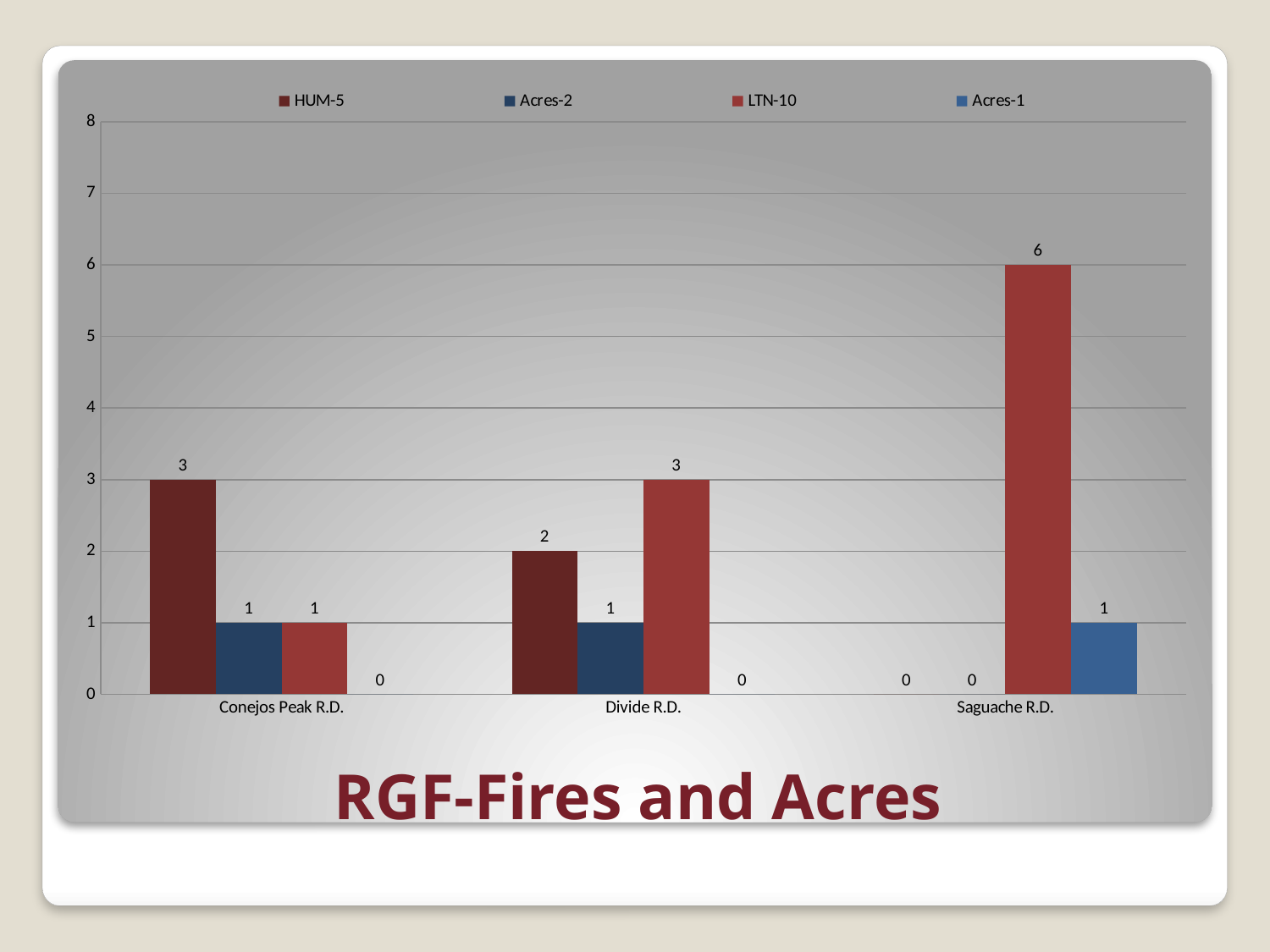
Which is larger: the HUM-5 value for Conejos Peak R.D. or the HUM-5 value for Divide R.D.? Conejos Peak R.D. What kind of chart is shown on the slide? Bar chart What is the title of the chart? RGF-Fires and Acres How many ranger districts are shown on the x axis? 3 How many series does the legend list? 4 Which ranger district has the highest LTN-10 value? Saguache R.D. What is the difference between the LTN-10 value for Saguache R.D. and the LTN-10 value for Divide R.D.? 3 What is the Acres-2 value for Divide R.D.? 1 What is the Acres-1 value for Conejos Peak R.D.? 0 What is the LTN-10 value for Saguache R.D.? 6 Which ranger district has the lowest HUM-5 value? Saguache R.D. What is the HUM-5 value for Conejos Peak R.D.? 3